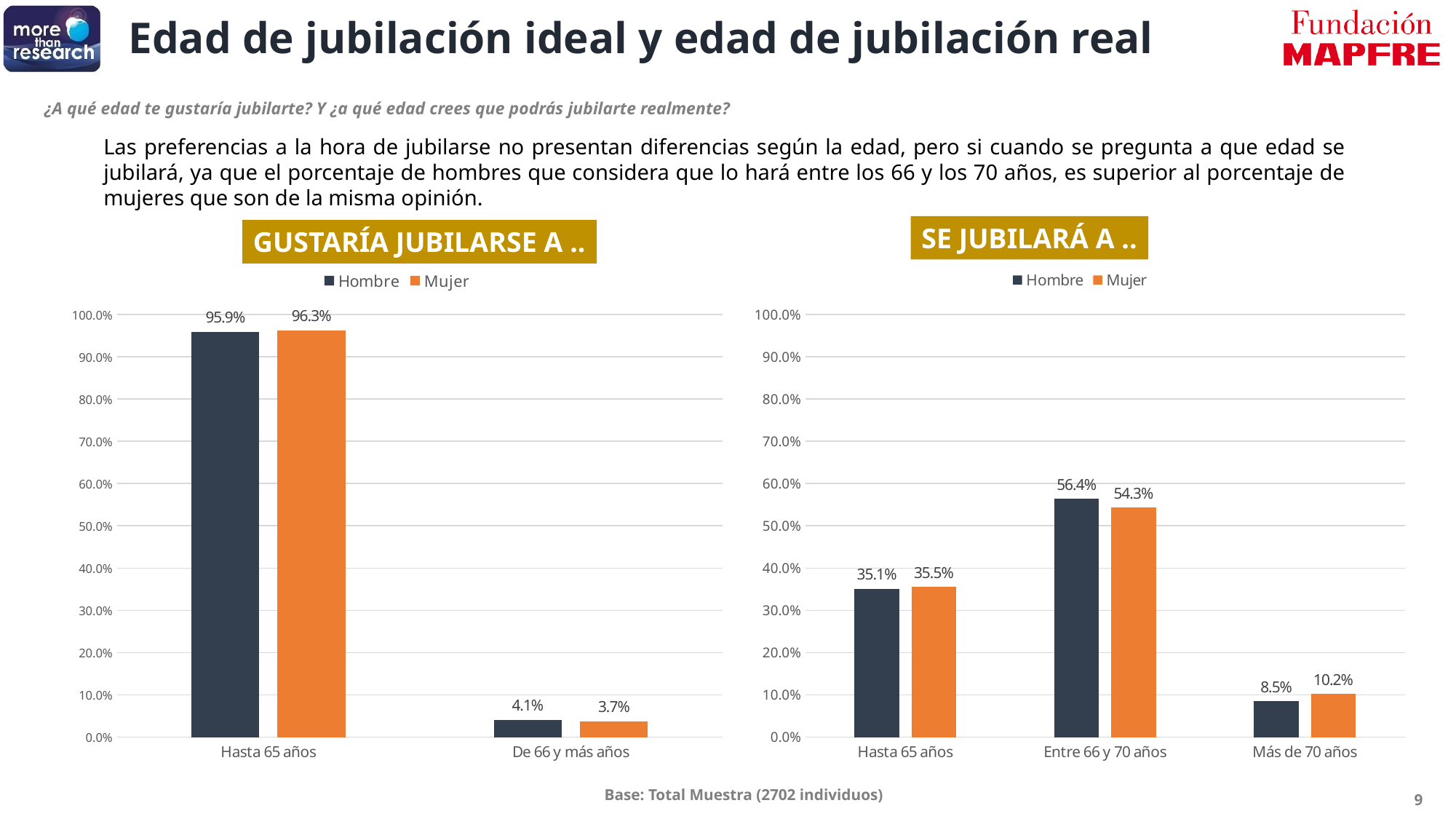
In the 'GUSTARÍA JUBILARSE A ..' chart, what is the value for Mujer in the 'De 66 y más años' category? 3.7% In the 'GUSTARÍA JUBILARSE A ..' chart, which is larger for 'Hasta 65 años': Hombre or Mujer? Mujer In the 'SE JUBILARÁ A ..' chart, is the value for Hombre in 'Hasta 65 años' greater or less than 40.0%? less What kind of chart is the 'SE JUBILARÁ A ..' chart? Bar chart In the 'SE JUBILARÁ A ..' chart, which category has the lowest value for Hombre? Más de 70 años In the 'SE JUBILARÁ A ..' chart, what is the value for Hombre in the 'Entre 66 y 70 años' category? 56.4% In the 'SE JUBILARÁ A ..' chart, what is the value for Mujer in the 'Más de 70 años' category? 10.2% In the 'GUSTARÍA JUBILARSE A ..' chart, what is the value for Hombre in the 'Hasta 65 años' category? 95.9% In the 'SE JUBILARÁ A ..' chart, which category has the highest value for Mujer? Entre 66 y 70 años In the 'SE JUBILARÁ A ..' chart, what is the difference between the Hombre and Mujer values for 'Entre 66 y 70 años'? 2.1% How many series does the legend of the 'GUSTARÍA JUBILARSE A ..' chart list? 2 How many categories are shown on the x axis of the 'SE JUBILARÁ A ..' chart? 3